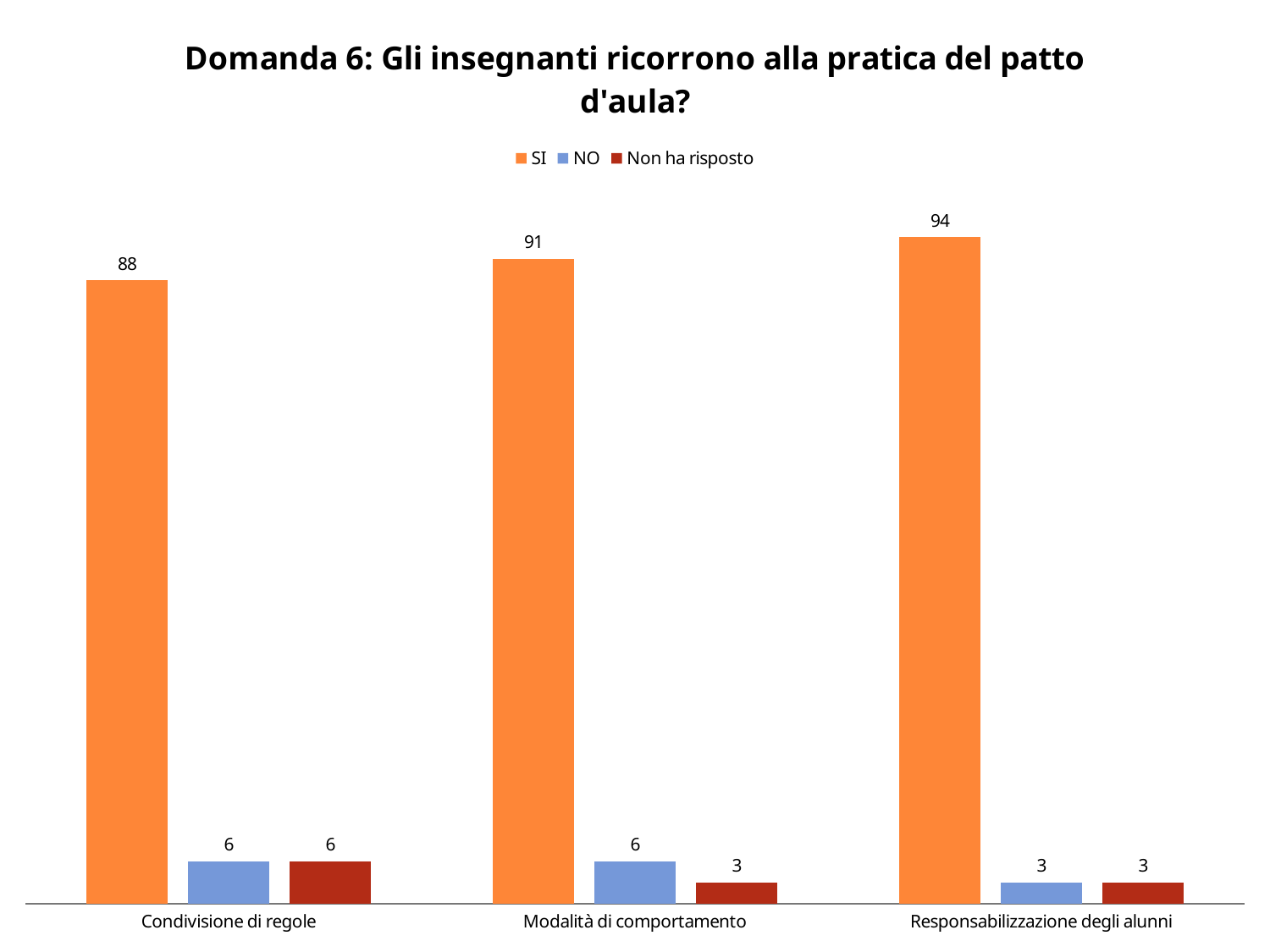
Do the SI values rise or fall from left to right across the categories? Rise What is the Non ha risposto value for Responsabilizzazione degli alunni? 3 What is the difference between the SI values for Responsabilizzazione degli alunni and Condivisione di regole? 6 Which category has the highest SI value? Responsabilizzazione degli alunni Which is larger: the NO value for Condivisione di regole or the NO value for Responsabilizzazione degli alunni? Condivisione di regole Which series is shown in orange? SI What is the SI value for Condivisione di regole? 88 How many categories are shown on the x axis? 3 What kind of chart is this? Bar chart How many series does the legend list? 3 What is the NO value for Modalità di comportamento? 6 Which category has the lowest SI value? Condivisione di regole